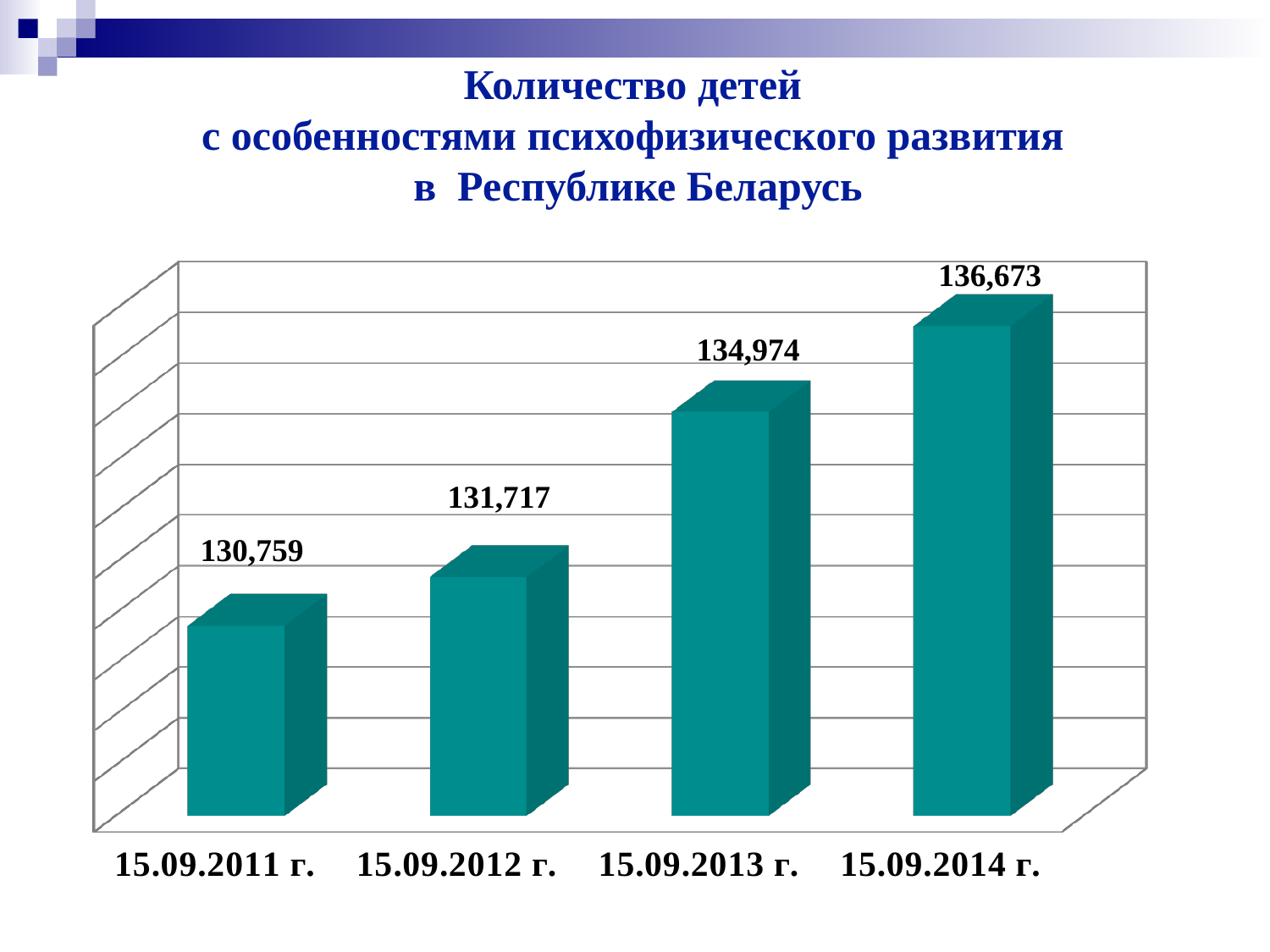
What is the value for 15.09.2014 г.? 136,673 What is the value for 15.09.2011 г.? 130,759 Which date has the lowest value? 15.09.2011 г. Which date has the highest value? 15.09.2014 г. How many bars are shown in the chart? 4 What is the difference between the values for 15.09.2014 г. and 15.09.2011 г.? 5,914 Which is larger, the value for 15.09.2013 г. or the value for 15.09.2012 г.? 15.09.2013 г. What is the value for 15.09.2012 г.? 131,717 Do the values rise or fall from 15.09.2011 г. to 15.09.2014 г.? Rise What kind of chart is shown on the slide? Bar chart What is the difference between the values for 15.09.2013 г. and 15.09.2012 г.? 3,257 What is the value for 15.09.2013 г.? 134,974